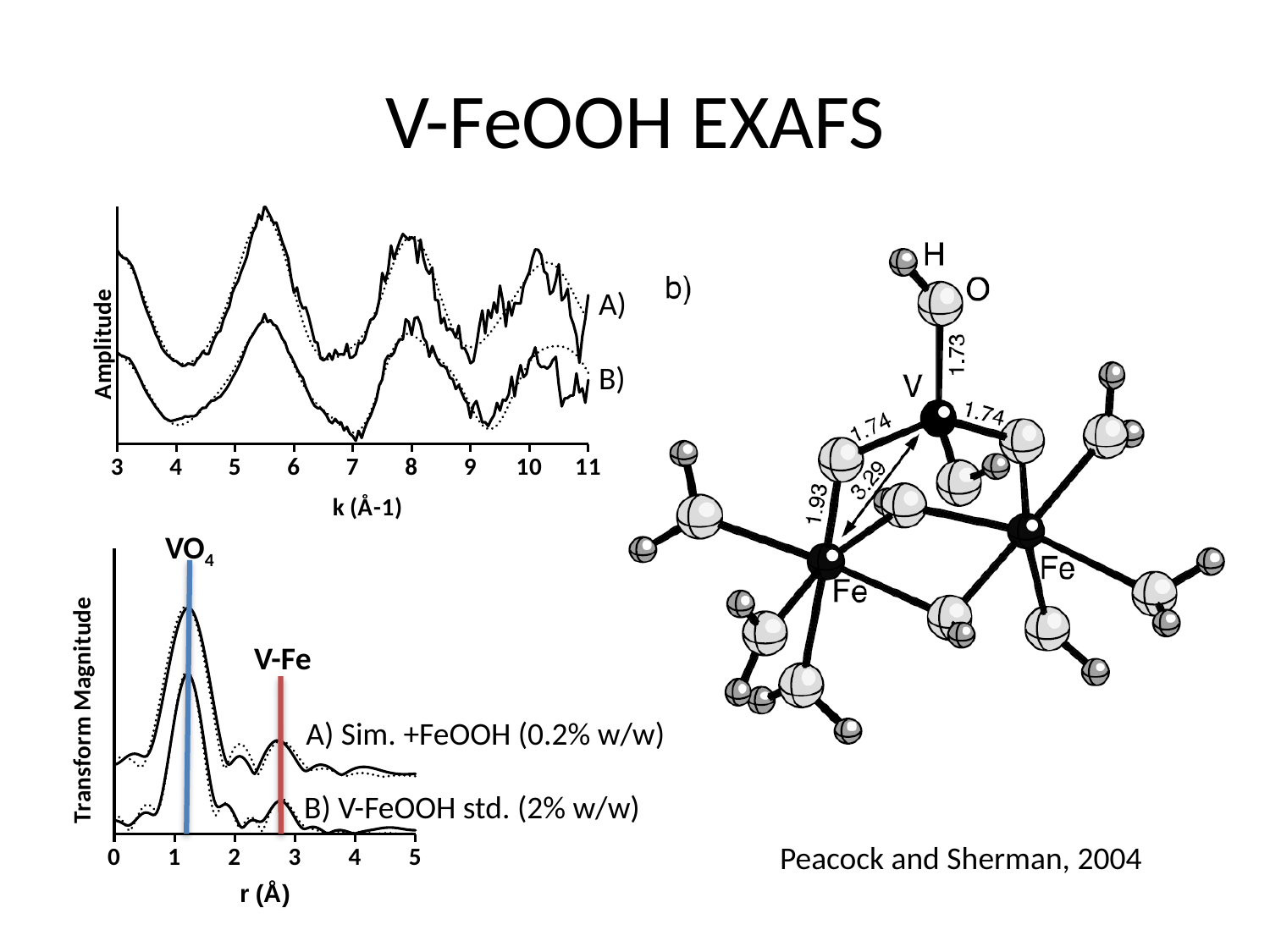
In the bottom chart, what is the label of trace A? A) Sim. +FeOOH (0.2% w/w) In the bottom chart, which peak is taller, the one marked VO4 or the one marked V-Fe? VO4 What kind of chart is the bottom chart (Transform Magnitude vs r)? line chart In the bottom chart, how many labelled traces are plotted? 2 In the top chart, is the k position of the tallest peak of trace A greater or less than 5? greater What kind of chart is the top chart (Amplitude vs k)? line chart In the bottom chart, is the r position of the peak marked V-Fe greater or less than 3? less In the bottom chart, is the r position of the peak marked VO4 greater or less than 2? less In the top chart, how many labelled traces are plotted? 2 In the top chart, what is the highest value shown on the x axis? 11